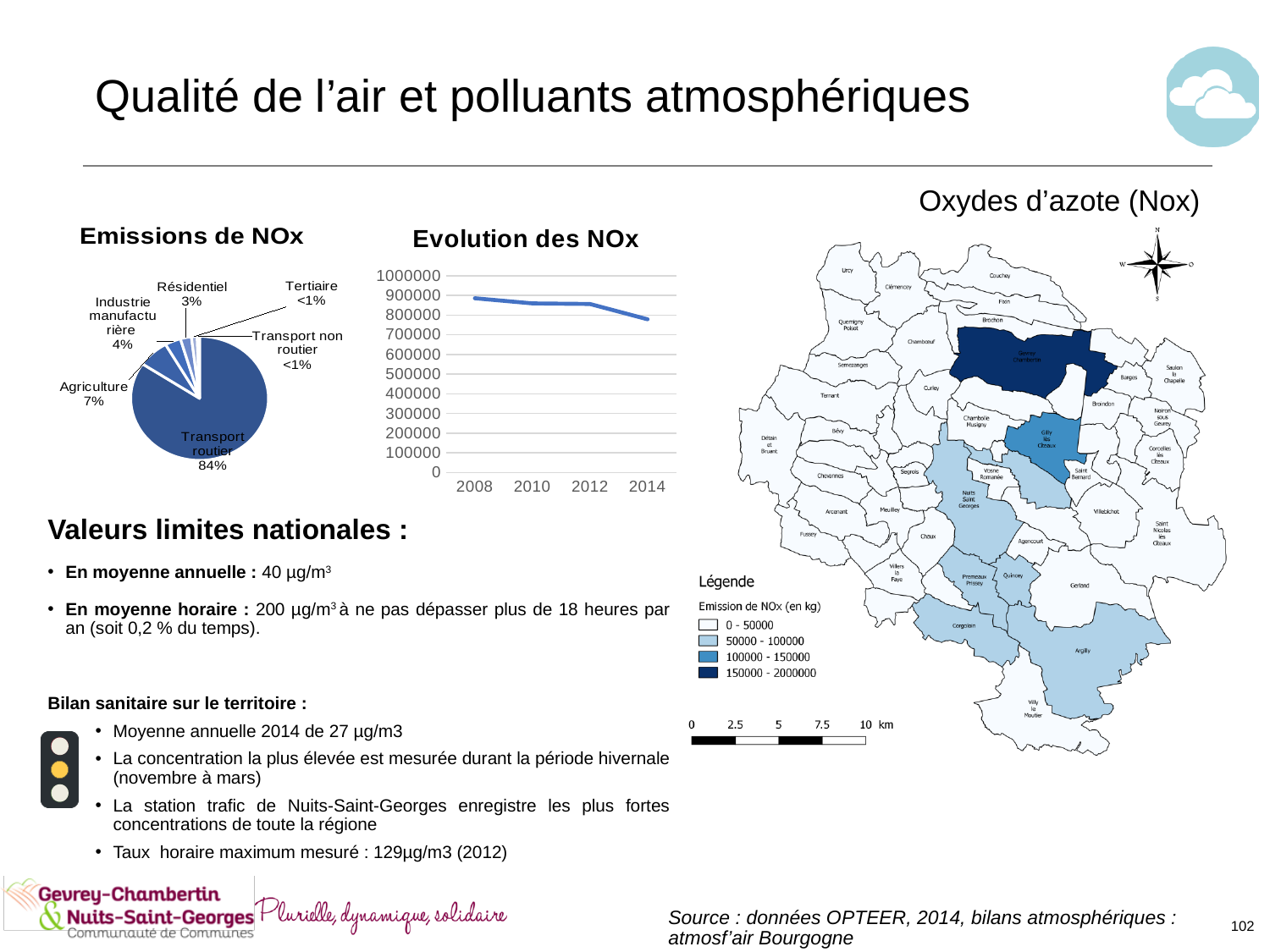
In the 'Emissions de NOx' pie chart, what share is attributed to Transport routier? 84% In the 'Emissions de NOx' pie chart, which sector has the largest share? Transport routier What kind of chart is 'Emissions de NOx'? Pie chart In the 'Emissions de NOx' pie chart, what is the difference in percentage points between Transport routier and Agriculture? 77 In the 'Emissions de NOx' pie chart, what share is attributed to Agriculture? 7% In the 'Evolution des NOx' chart, is the value for 2014 greater or less than 800000? less In the 'Emissions de NOx' pie chart, which is larger, the share for Agriculture or the share for Résidentiel? Agriculture In the 'Emissions de NOx' pie chart, what share is attributed to Résidentiel? 3% How many sectors are labelled in the 'Emissions de NOx' pie chart? 6 In the 'Evolution des NOx' chart, do the values rise or fall from 2008 to 2014? Fall In the 'Emissions de NOx' pie chart, what share is attributed to Industrie manufacturière? 4% What kind of chart is 'Evolution des NOx'? Line chart